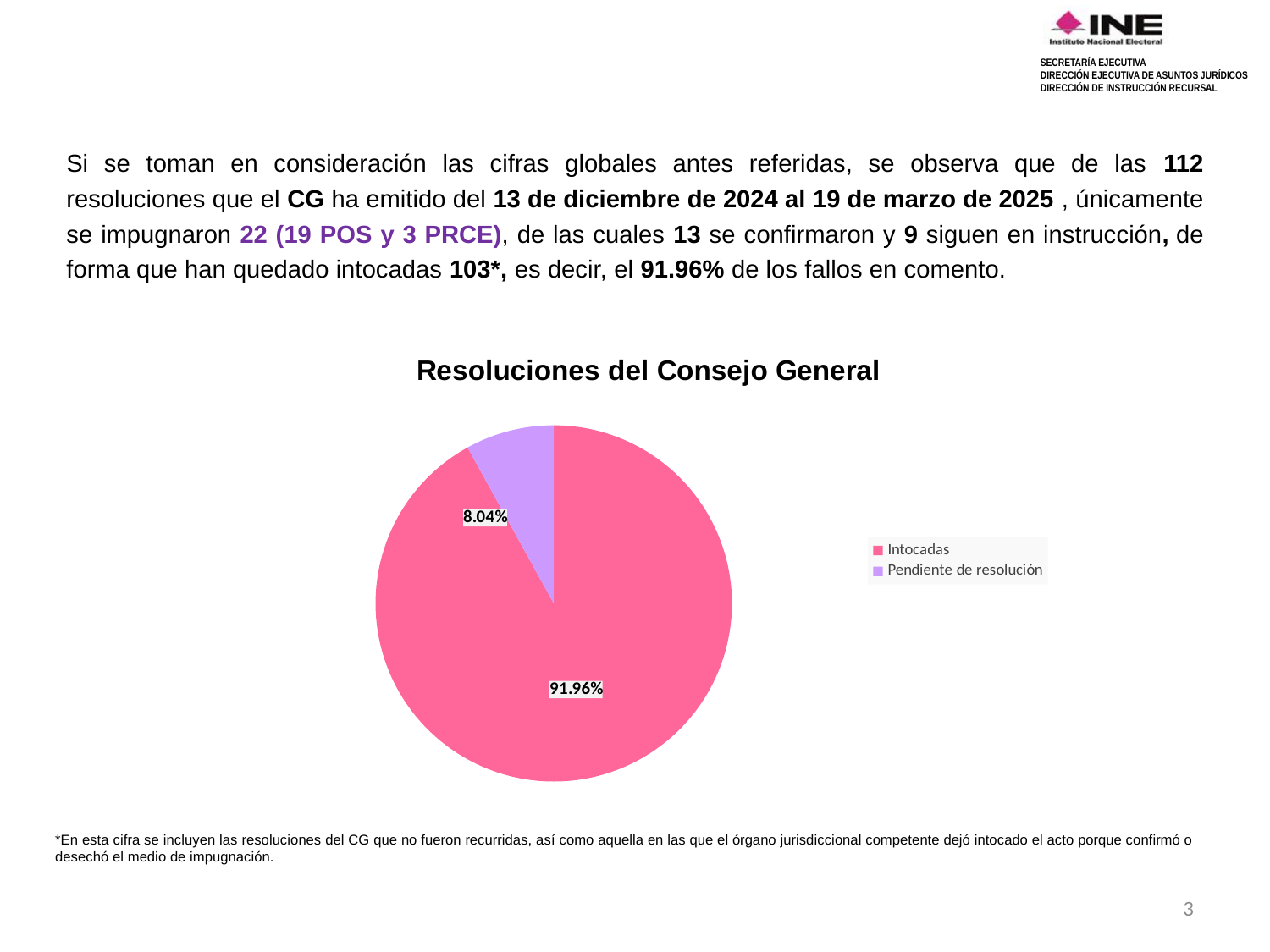
Which is larger, the Intocadas slice or the Pendiente de resolución slice? Intocadas What is the title of the chart? Resoluciones del Consejo General What share of the pie does the Pendiente de resolución slice represent? 8.04% What is the difference in percentage points between the Intocadas slice and the Pendiente de resolución slice? 83.92 Which category has the smallest slice of the pie? Pendiente de resolución What kind of chart is shown on the slide? Pie chart How many categories does the pie chart show? 2 How many entries does the legend list? 2 What colour is the Pendiente de resolución slice? Purple Which category has the largest slice of the pie? Intocadas What share of the pie does the Intocadas slice represent? 91.96%